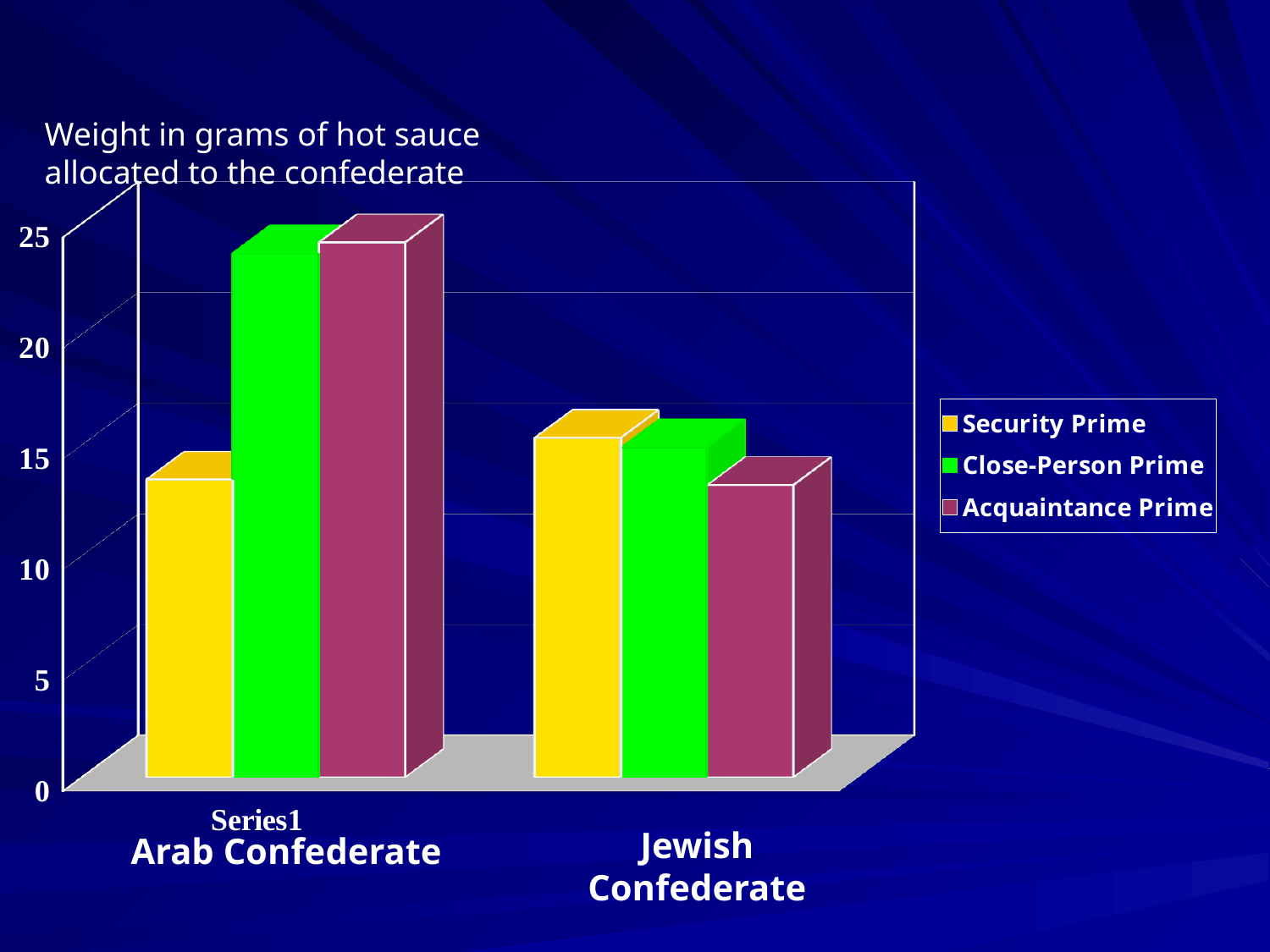
Which prime condition has the lowest value for the Jewish Confederate? Acquaintance Prime How many confederate categories are shown on the x axis? 2 Which prime condition has the lowest value for the Arab Confederate? Security Prime How many series does the legend list? 3 Is the value for Acquaintance Prime for the Jewish Confederate greater or less than 15? less Is the value for Acquaintance Prime for the Arab Confederate greater or less than 20? greater Is the value for Close-Person Prime for the Jewish Confederate greater or less than 20? less For Close-Person Prime, which confederate has the larger value, Arab or Jewish? Arab Confederate What kind of chart is shown on the slide? Bar chart Which series is shown in green in the legend? Close-Person Prime